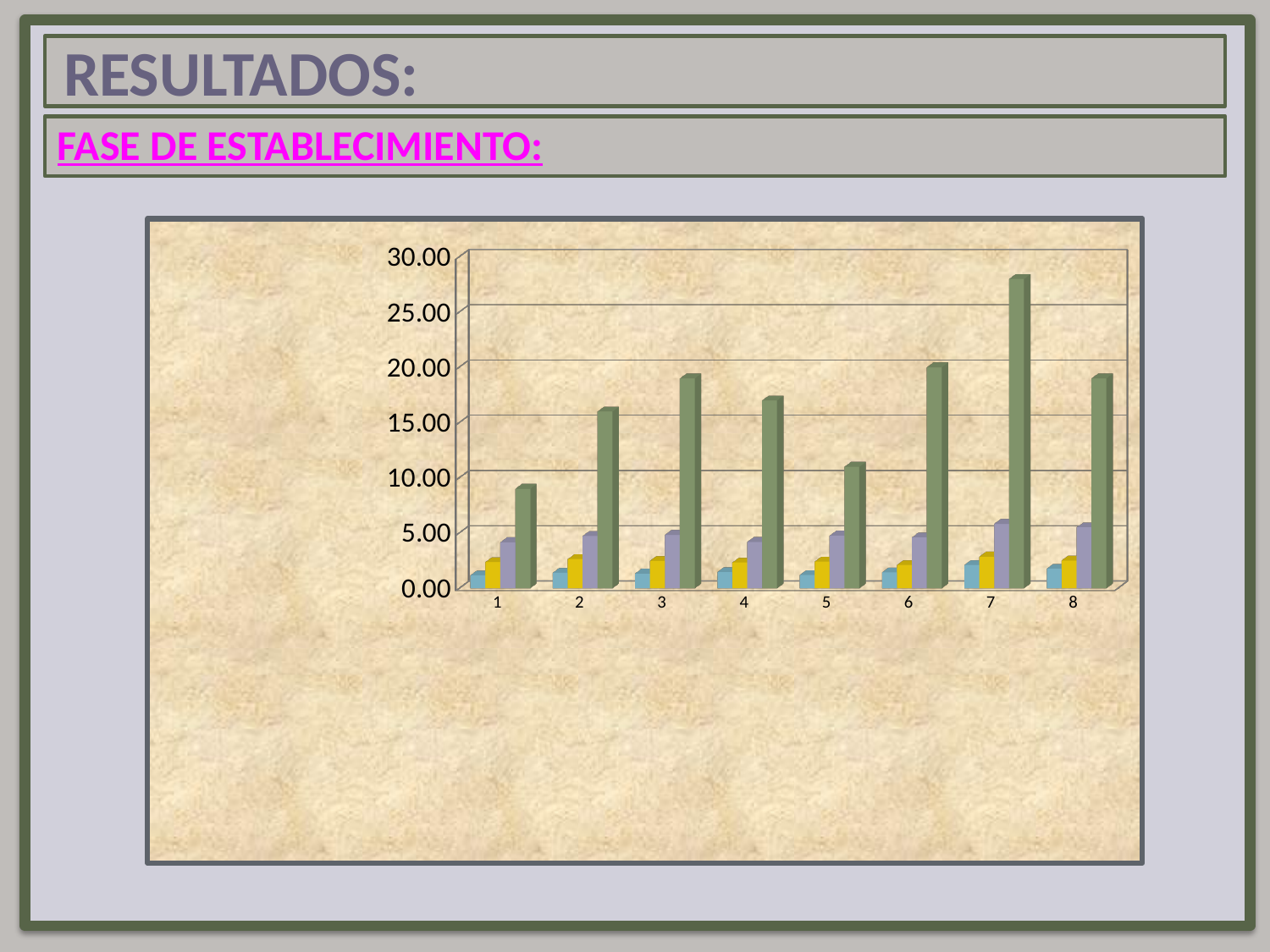
Which category has the shortest green bar in the chart? 1 How many bars are plotted for each category in the chart? 4 Which is taller in the chart, the green bar for category 2 or the green bar for category 5? category 2 What kind of chart is shown on the slide? bar chart How many categories are shown along the x axis of the chart? 8 Is the green bar for category 7 greater or less than 25.00? greater Which category has the tallest green bar in the chart? 7 What is the highest value shown on the y axis of the chart? 30.00 Is the green bar for category 1 greater or less than 10.00? less Which colour of bar is the tallest in every category of the chart? green Is the green bar for category 5 greater or less than 15.00? less